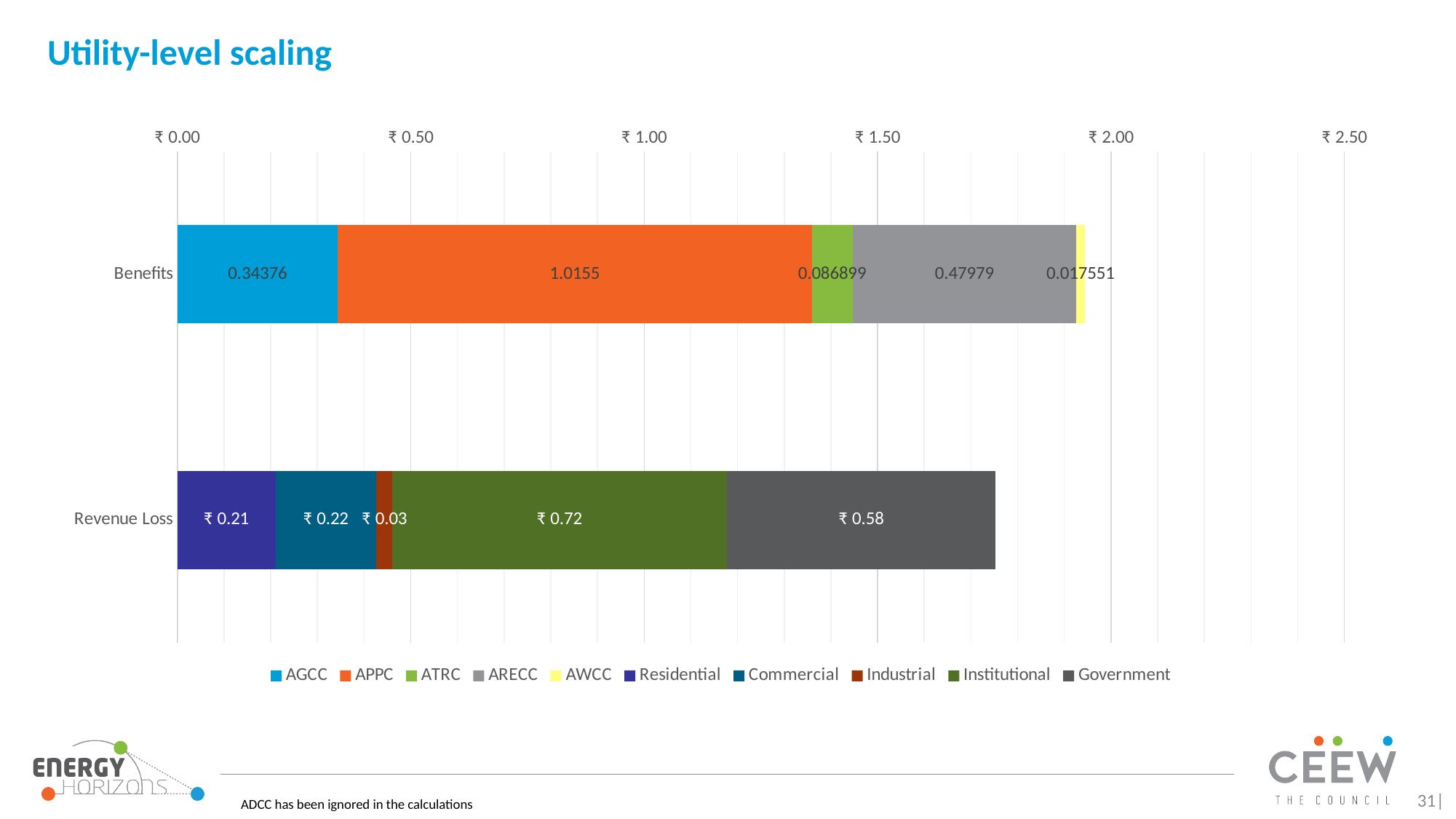
Which segment is the largest in the Benefits bar? APPC How many categories are shown on the vertical axis? 2 What is the value of the Institutional segment in the Revenue Loss bar? ₹ 0.72 Which is larger in the Benefits bar, the AGCC segment or the ARECC segment? ARECC What kind of chart is shown on the slide? Stacked bar chart Which segment is the smallest in the Revenue Loss bar? Industrial Is the total of the Revenue Loss bar greater or less than ₹ 2.00? less How many series does the legend list? 10 What is the value of the APPC segment in the Benefits bar? 1.0155 What is the total of the Revenue Loss bar? ₹ 1.76 What is the value of the AWCC segment in the Benefits bar? 0.017551 What is the difference between the Institutional and Government segments in the Revenue Loss bar? ₹ 0.14